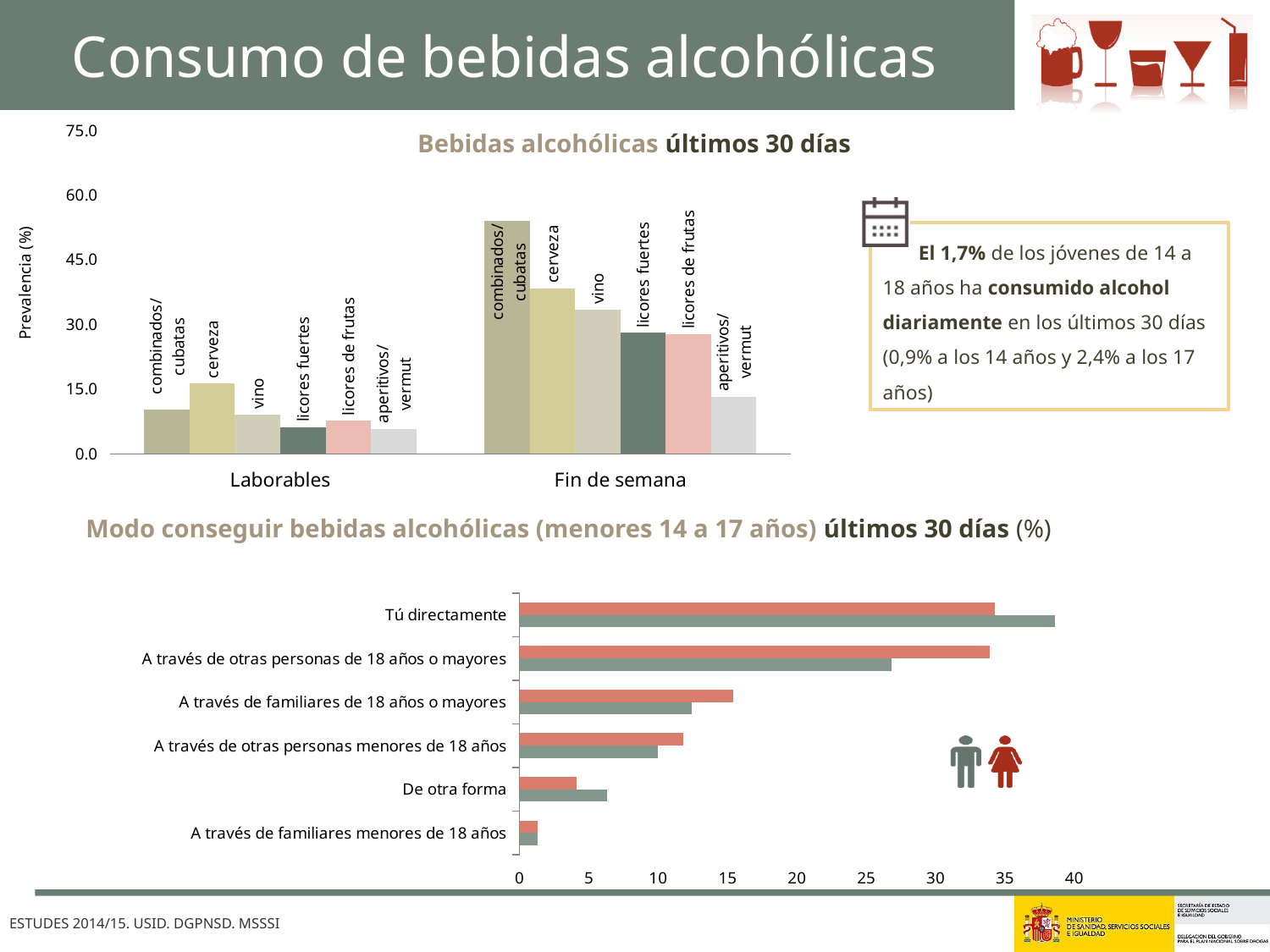
In the chart 'Bebidas alcohólicas últimos 30 días', which beverage has the lowest prevalence in the 'Fin de semana' group? aperitivos/vermut In the chart 'Bebidas alcohólicas últimos 30 días', what is the label of the vertical axis? Prevalencia (%) In the chart 'Modo conseguir bebidas alcohólicas (menores 14 a 17 años) últimos 30 días', how many categories are listed on the vertical axis? 6 In the chart 'Modo conseguir bebidas alcohólicas (menores 14 a 17 años) últimos 30 días', which category has the longest bar? Tú directamente In the chart 'Bebidas alcohólicas últimos 30 días', is the value for combinados/cubatas in 'Fin de semana' greater or less than 45.0? greater In the chart 'Bebidas alcohólicas últimos 30 días', which beverage has the highest prevalence in the 'Fin de semana' group? combinados/cubatas In the chart 'Modo conseguir bebidas alcohólicas (menores 14 a 17 años) últimos 30 días', which category has the shortest bars? A través de familiares menores de 18 años In the chart 'Bebidas alcohólicas últimos 30 días', which beverage has the highest prevalence in the 'Laborables' group? cerveza What kind of chart is 'Modo conseguir bebidas alcohólicas (menores 14 a 17 años) últimos 30 días'? bar chart In the chart 'Bebidas alcohólicas últimos 30 días', which is larger in the 'Fin de semana' group: vino or licores fuertes? vino In the chart 'Bebidas alcohólicas últimos 30 días', is the value for combinados/cubatas in 'Laborables' greater or less than 15.0? less In the chart 'Modo conseguir bebidas alcohólicas (menores 14 a 17 años) últimos 30 días', is the green bar for 'Tú directamente' greater or less than 35? greater